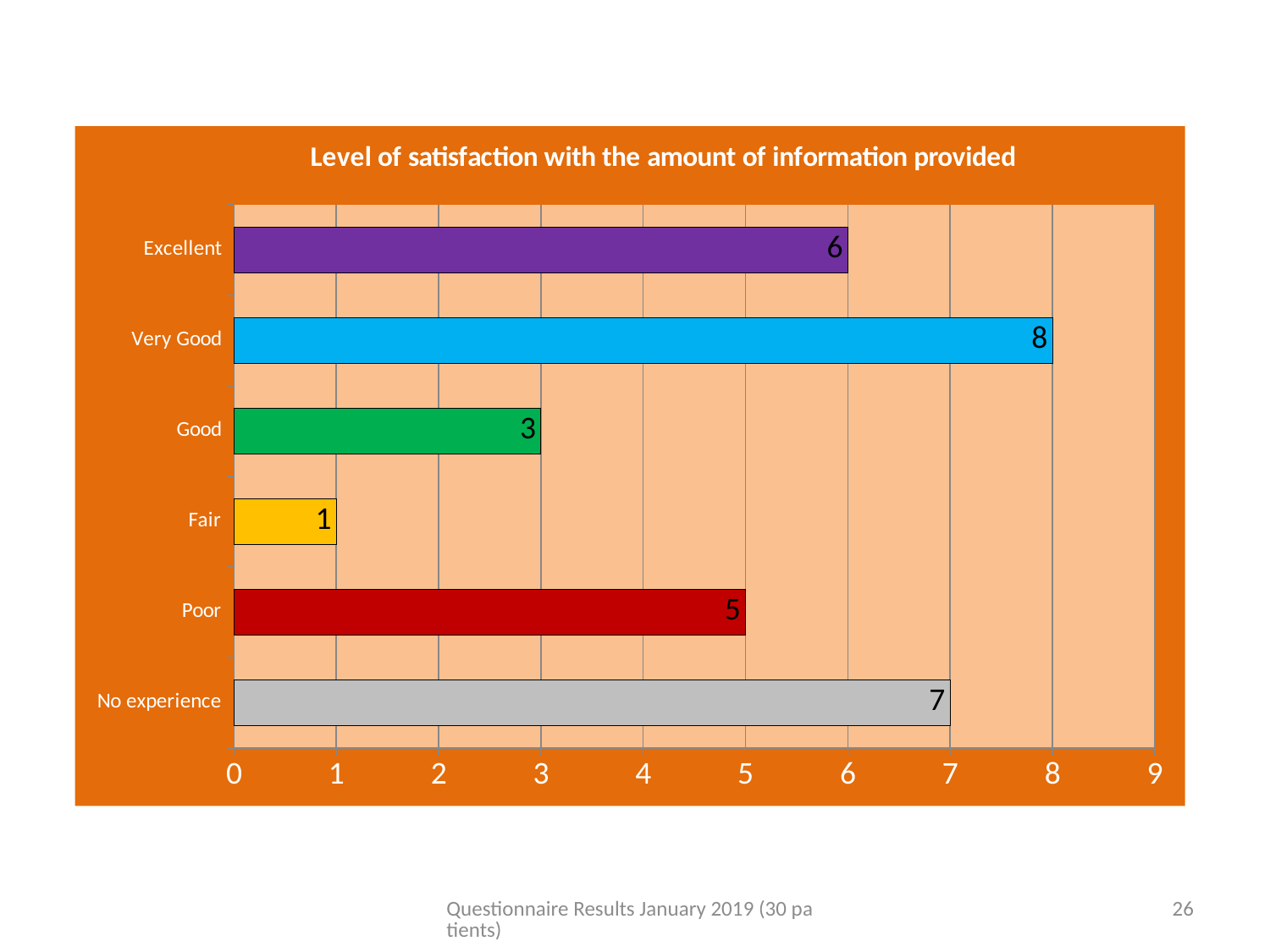
What is the value for No experience? 7 What is the title of the chart? Level of satisfaction with the amount of information provided What is the difference between the values for Very Good and Good? 5 What is the value for Very Good? 8 Is the value for Excellent greater or less than 5? greater What is the difference between the values for No experience and Poor? 2 Which category has the highest value? Very Good What is the value for Fair? 1 Which is larger, the value for Excellent or the value for Poor? Excellent Which category has the lowest value? Fair How many categories are shown in the chart? 6 What kind of chart is shown on the slide? bar chart